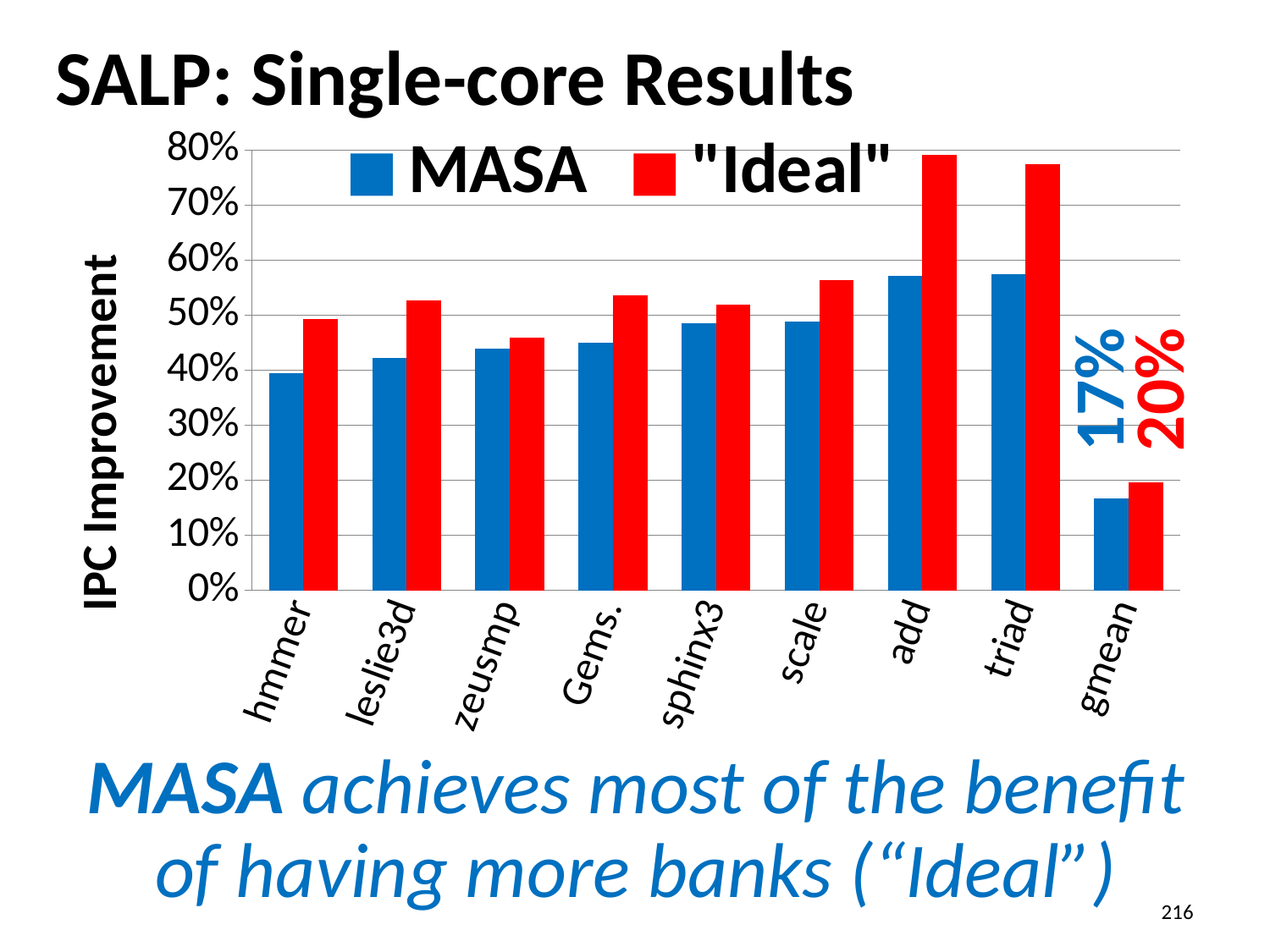
What type of chart is shown on the slide? bar chart For hmmer, which is larger: the MASA value or the "Ideal" value? "Ideal" Is the MASA value for zeusmp greater or less than 50%? less Which category has the lowest MASA value? gmean How many categories are shown on the x axis? 9 What is the "Ideal" value for gmean? 20% Is the "Ideal" value for triad greater or less than 70%? greater What is the MASA value for gmean? 17% What is the difference between the "Ideal" and MASA values for gmean? 3% How many series does the legend list? 2 What is the label of the y axis? IPC Improvement Which category has the highest "Ideal" value? add